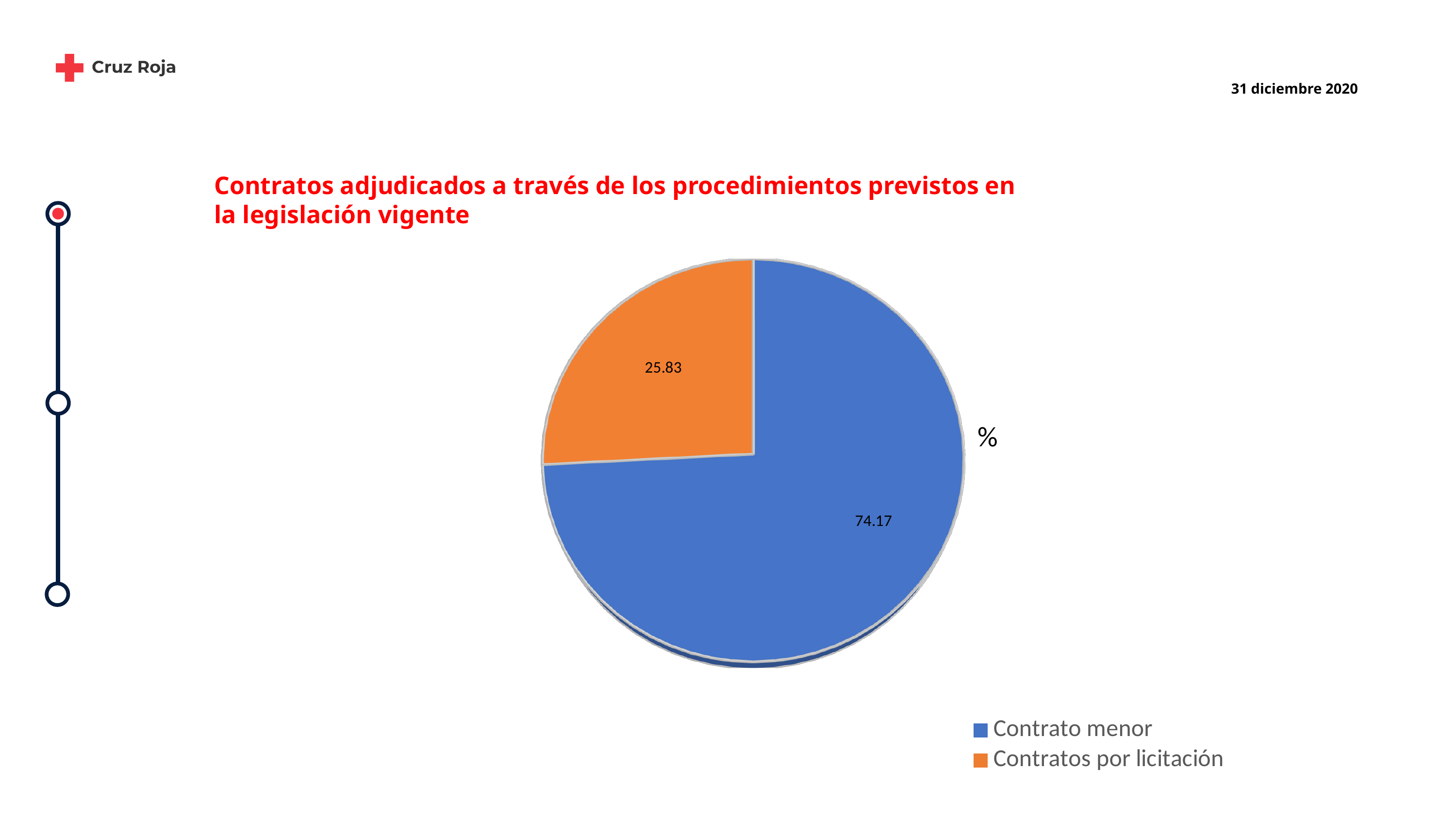
Which is larger, the value for Contrato menor or the value for Contratos por licitación? Contrato menor What is the total of the two values shown on the pie chart? 100 What kind of chart is shown on the slide? Pie chart Which category has the largest slice of the pie? Contrato menor How many entries does the legend list? 2 What colour is the slice for Contratos por licitación? Orange How many slices does the pie chart have? 2 What is the value shown for Contratos por licitación? 25.83 What is the difference between the values for Contrato menor and Contratos por licitación? 48.34 What is the value shown for Contrato menor? 74.17 What is the title of the chart? % Which category has the smallest slice of the pie? Contratos por licitación